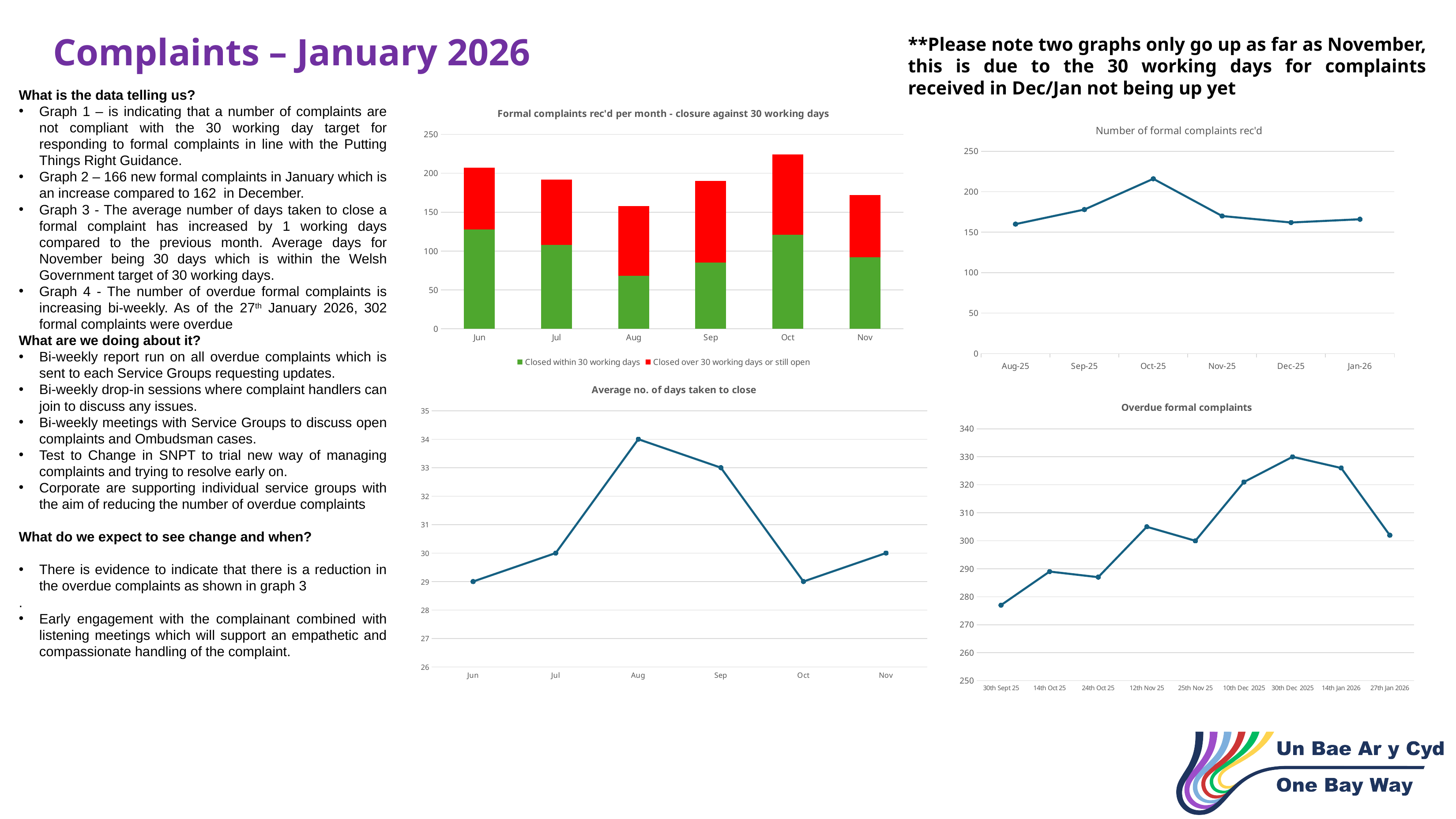
In the 'Formal complaints rec'd per month - closure against 30 working days' chart, is the total bar for Oct greater or less than 200? greater In the 'Average no. of days taken to close' chart, what is the value for Aug? 34 In the 'Overdue formal complaints' chart, which date has the highest value? 30th Dec 2025 In the 'Number of formal complaints rec'd' chart, how many data points are plotted? 6 In the 'Average no. of days taken to close' chart, what is the value for Jun? 29 How many series does the legend list in the 'Formal complaints rec'd per month - closure against 30 working days' chart? 2 In the 'Overdue formal complaints' chart, what is the value for 25th Nov 25? 300 What kind of chart is 'Formal complaints rec'd per month - closure against 30 working days'? bar chart In the 'Number of formal complaints rec'd' chart, which month has the highest value? Oct-25 In the 'Formal complaints rec'd per month - closure against 30 working days' chart, which month has the shortest stacked bar? Aug In the 'Formal complaints rec'd per month - closure against 30 working days' chart, which month has the tallest stacked bar? Oct In the 'Average no. of days taken to close' chart, what is the difference between the values for Aug and Jun? 5